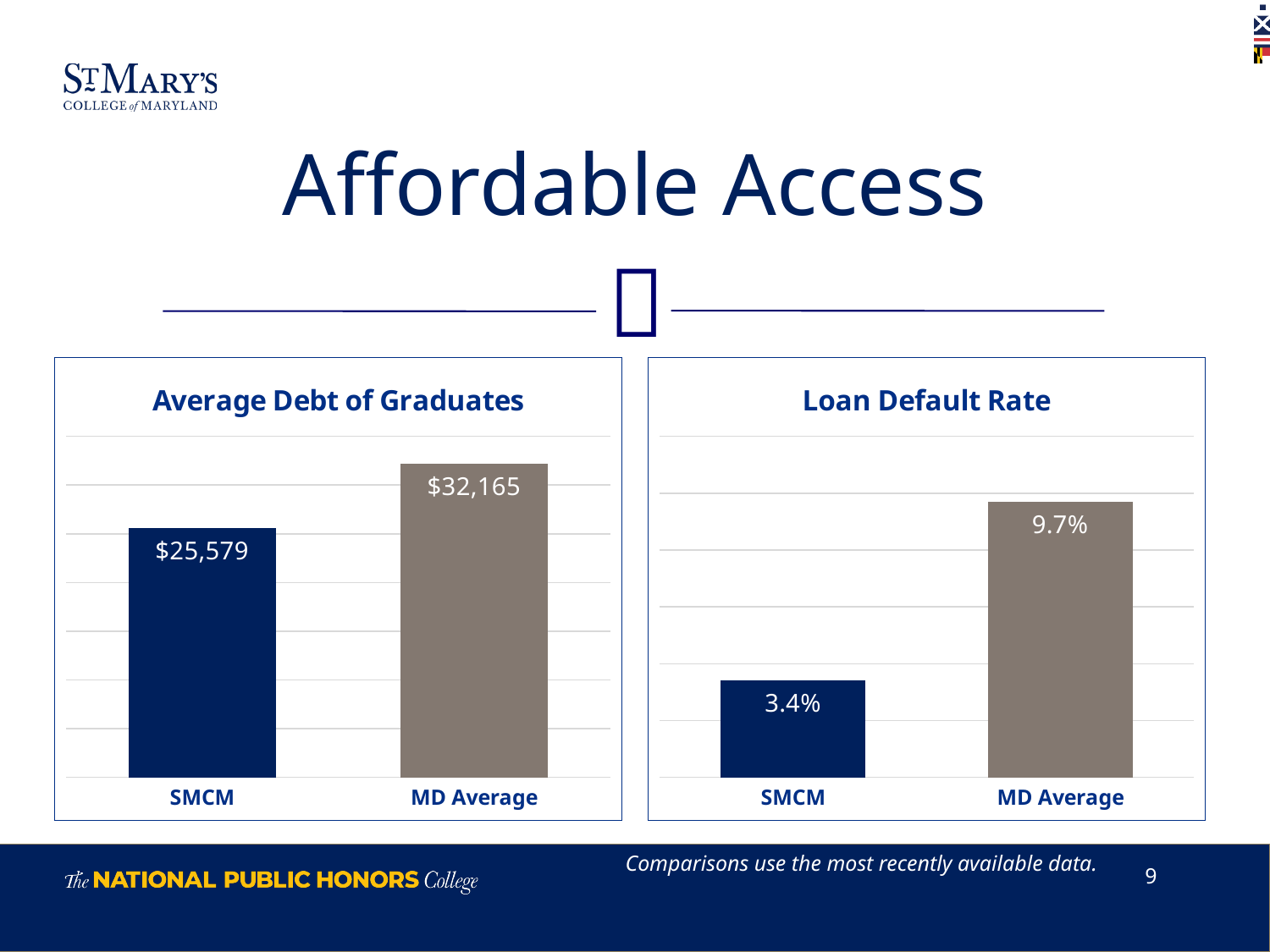
In the 'Average Debt of Graduates' chart, what is the value for MD Average? $32,165 In the 'Loan Default Rate' chart, what is the difference between the MD Average and SMCM values? 6.3% What kind of chart is the 'Loan Default Rate' chart? Bar chart In the 'Loan Default Rate' chart, which category has the lowest value? SMCM In the 'Loan Default Rate' chart, what is the value for MD Average? 9.7% In the 'Average Debt of Graduates' chart, what is the value for SMCM? $25,579 In the 'Average Debt of Graduates' chart, what is the difference between the MD Average and SMCM values? $6,586 In the 'Loan Default Rate' chart, what is the value for SMCM? 3.4% What is the title of the chart on the left side of the slide? Average Debt of Graduates How many categories are shown in the 'Average Debt of Graduates' chart? 2 In the 'Loan Default Rate' chart, which is larger: SMCM or MD Average? MD Average In the 'Average Debt of Graduates' chart, which category has the highest value? MD Average